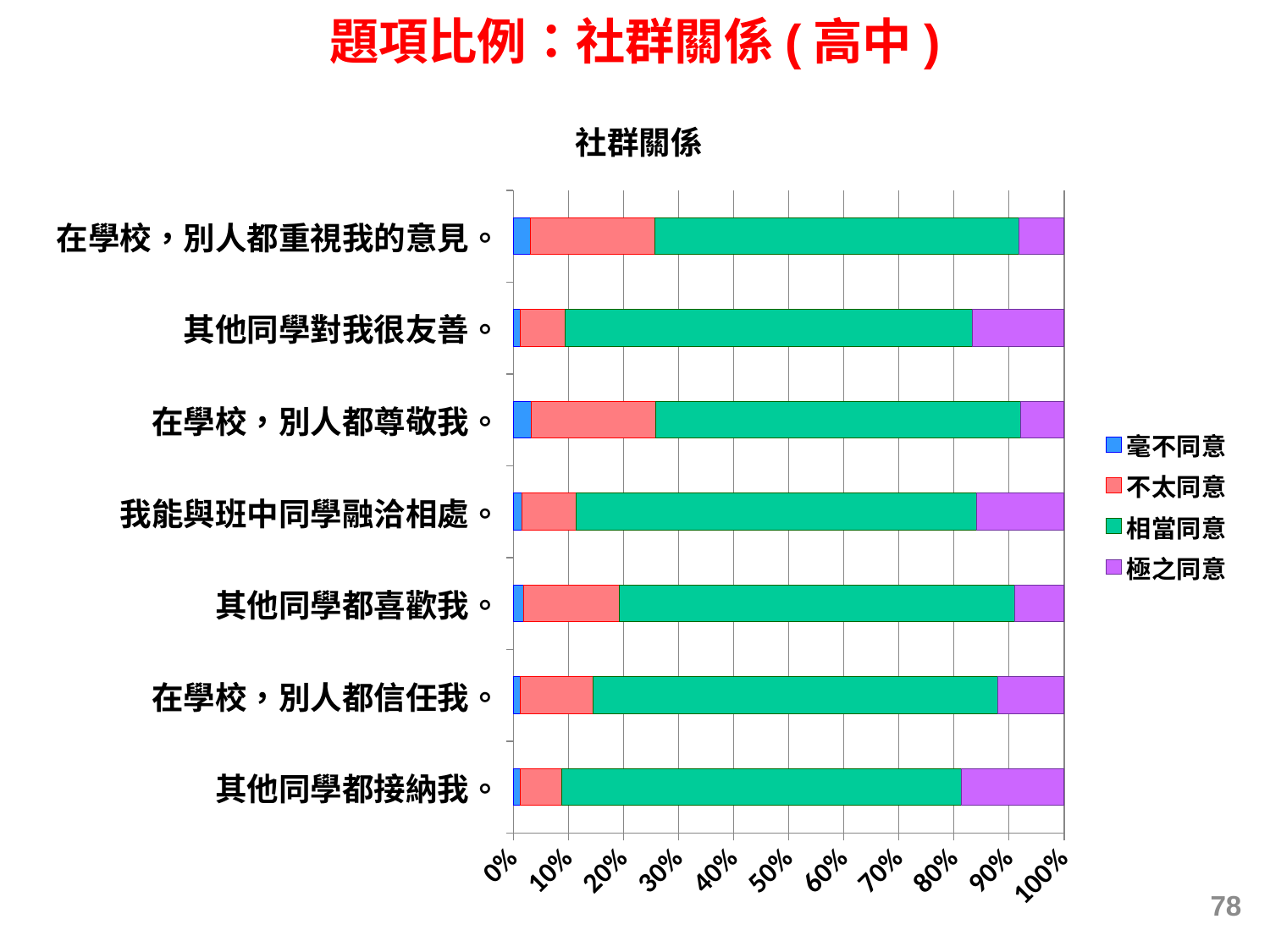
Which has the larger 不太同意 share: 其他同學都喜歡我 or 其他同學對我很友善? 其他同學都喜歡我 Is the 毫不同意 share for 在學校，別人都重視我的意見 greater or less than 10%? less Which has the larger 相當同意 share: 其他同學都接納我 or 在學校，別人都尊敬我? 其他同學都接納我 Is the 相當同意 share for 其他同學都接納我 greater or less than 60%? greater Which colour represents 相當同意 in the chart? Green Is the 極之同意 share for 在學校，別人都重視我的意見 greater or less than 20%? less What is the title of the chart? 社群關係 Which has the larger 極之同意 share: 其他同學都接納我 or 在學校，別人都重視我的意見? 其他同學都接納我 How many series does the legend list? 4 What kind of chart is shown on the slide? Stacked bar chart How many statements (categories) are plotted in the chart? 7